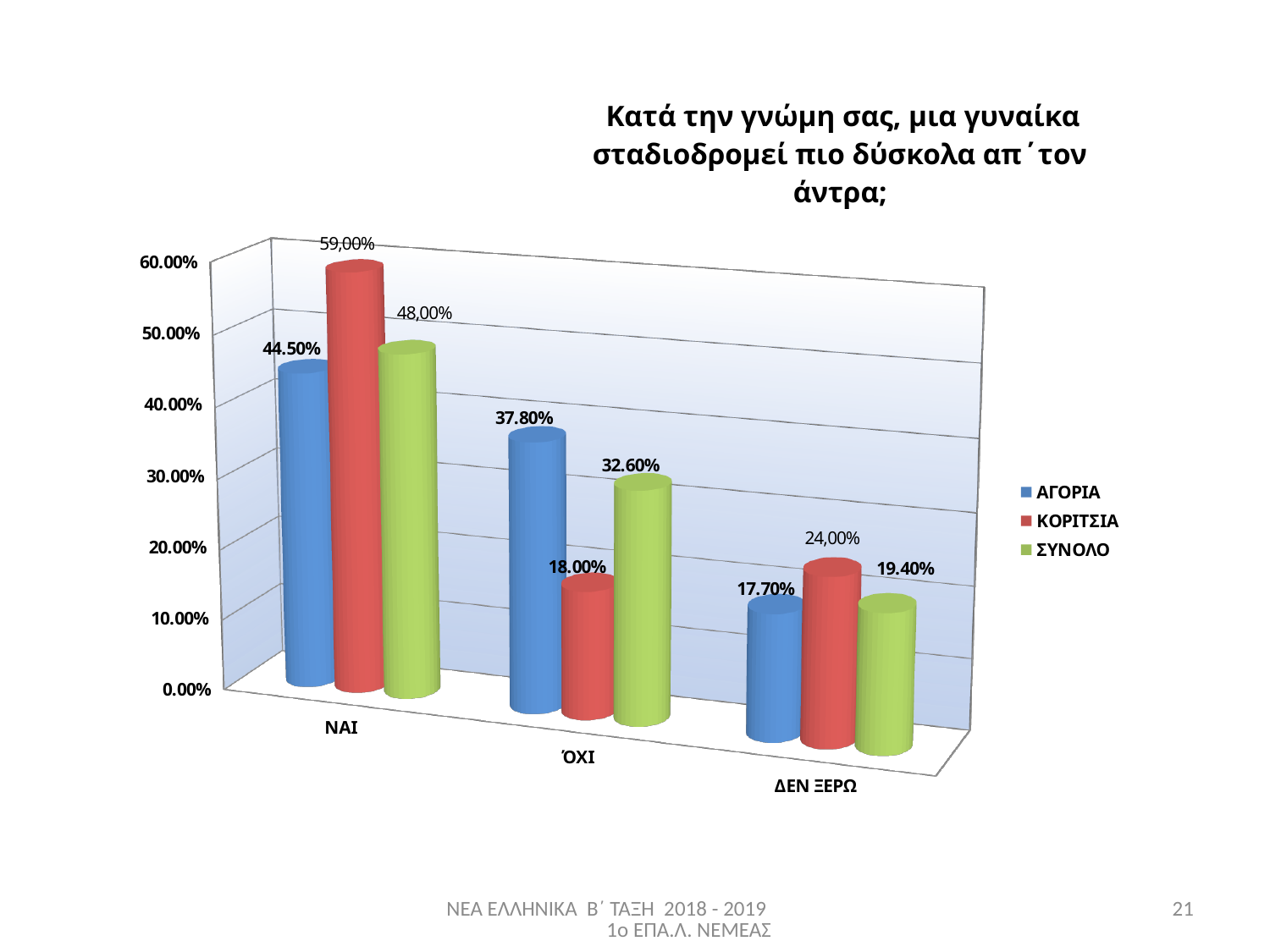
Which series is shown in red in the legend? ΚΟΡΙΤΣΙΑ What is the value for ΑΓΟΡΙΑ in the ΌΧΙ category? 37.80% What kind of chart is shown on the slide? bar chart What is the value for ΣΥΝΟΛΟ in the ΔΕΝ ΞΕΡΩ category? 19.40% What is the value for ΑΓΟΡΙΑ in the ΝΑΙ category? 44.50% Which category has the highest value for ΚΟΡΙΤΣΙΑ? ΝΑΙ How many series does the legend list? 3 How many categories are shown on the x axis? 3 In the ΔΕΝ ΞΕΡΩ category, which is larger: ΑΓΟΡΙΑ or ΚΟΡΙΤΣΙΑ? ΚΟΡΙΤΣΙΑ What is the difference between the ΑΓΟΡΙΑ and ΚΟΡΙΤΣΙΑ values in the ΌΧΙ category? 19.80% What is the value for ΚΟΡΙΤΣΙΑ in the ΝΑΙ category? 59,00% Which category has the lowest value for ΑΓΟΡΙΑ? ΔΕΝ ΞΕΡΩ